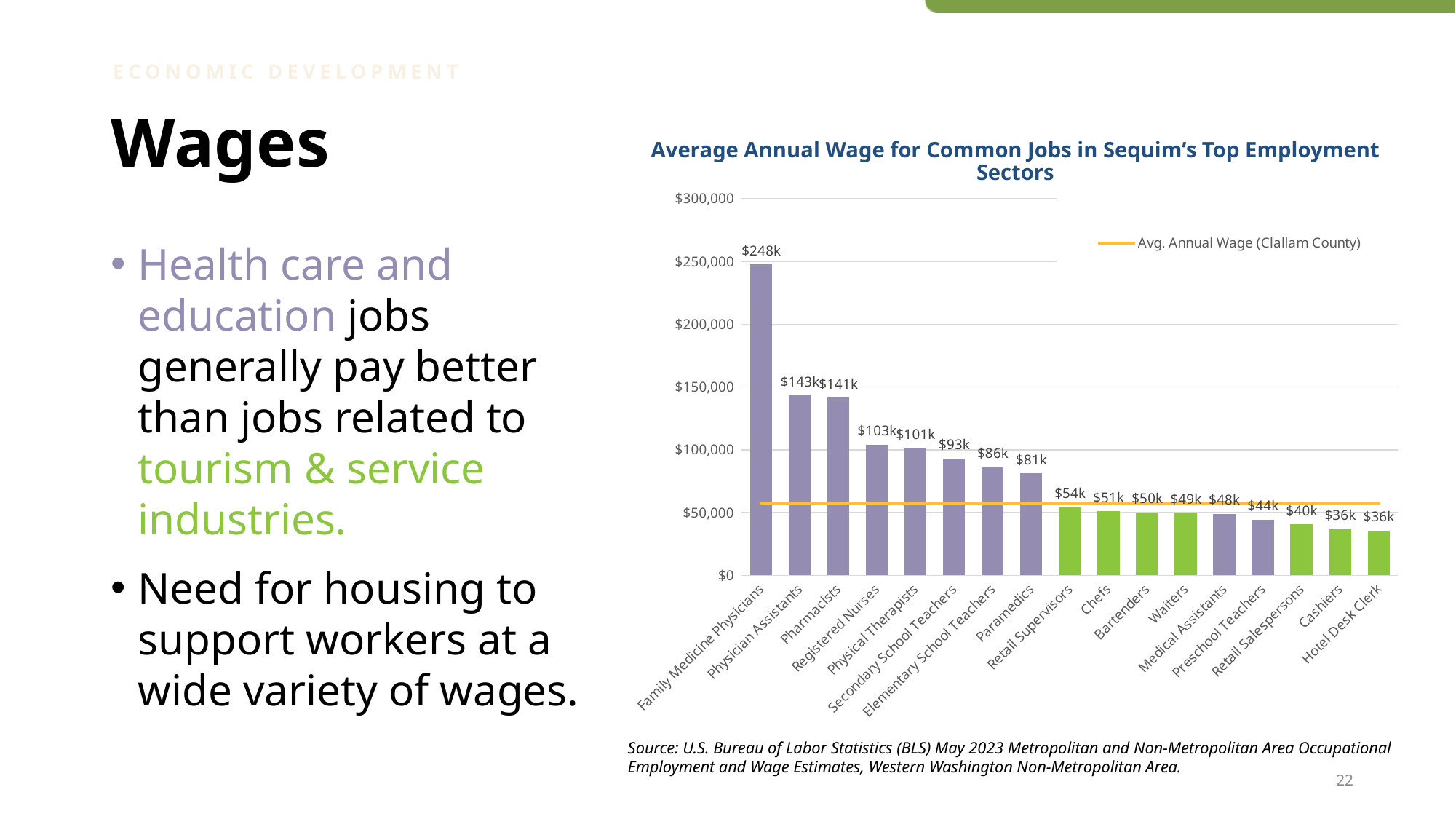
What is the difference between the average annual wage for Secondary School Teachers and Elementary School Teachers? $7k Which job has the highest average annual wage? Family Medicine Physicians What is the average annual wage for Paramedics? $81k What is the difference between the average annual wage for Physician Assistants and Registered Nurses? $40k What kind of chart is used to show the average annual wages? Bar chart Which has a higher average annual wage, Chefs or Retail Salespersons? Chefs How many jobs are shown on the chart? 17 What is the average annual wage for Pharmacists? $141k Do the wages rise or fall moving from left to right along the x axis? Fall What does the legend entry for the horizontal line say? Avg. Annual Wage (Clallam County) Is the average annual wage for Physical Therapists greater or less than $100,000? greater What is the average annual wage for Preschool Teachers? $44k